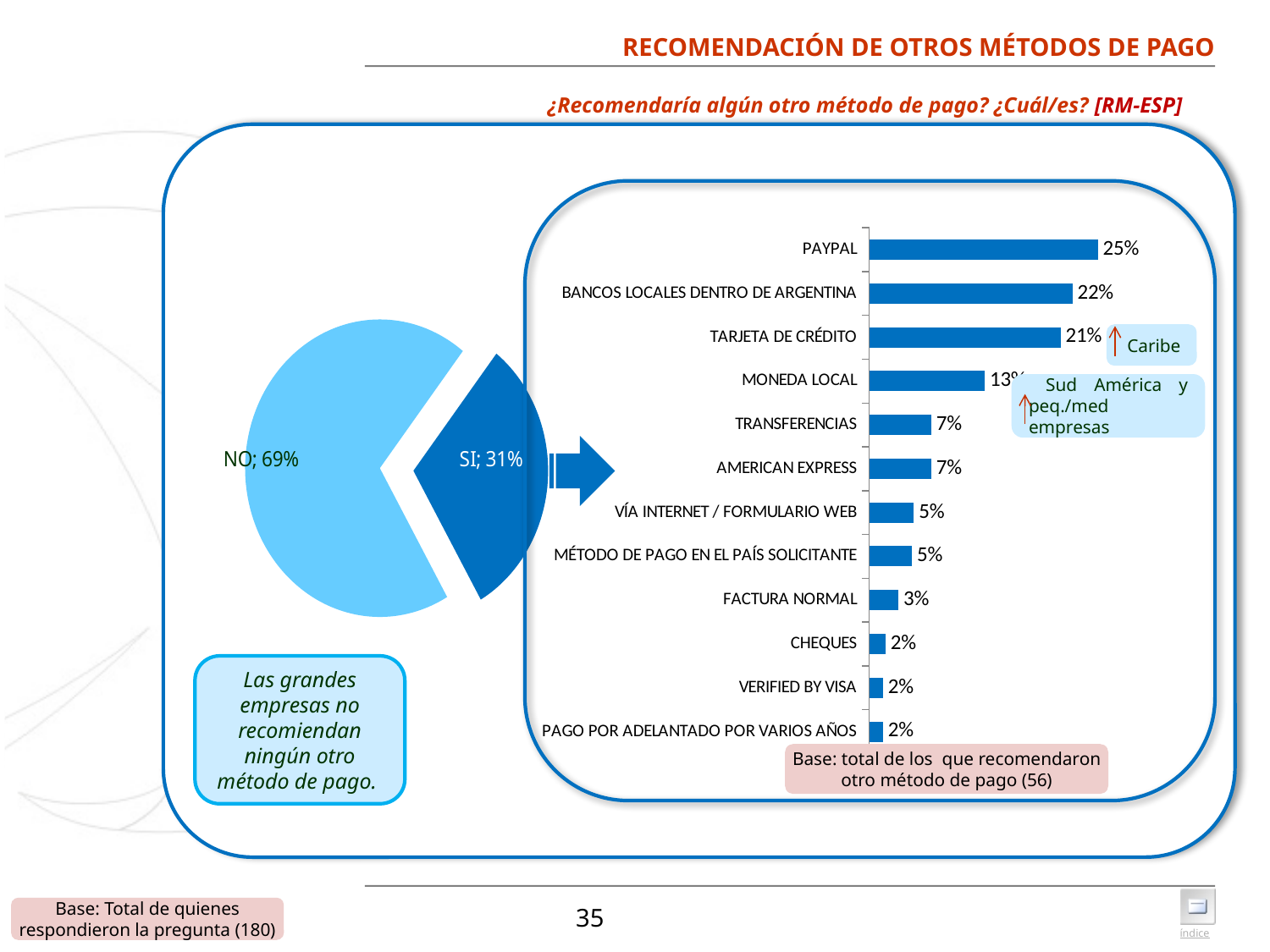
In the bar chart on the right, which is larger, TRANSFERENCIAS or VÍA INTERNET / FORMULARIO WEB? TRANSFERENCIAS In the bar chart on the right, what is the value for TARJETA DE CRÉDITO? 21% In the bar chart on the right, what is the value for BANCOS LOCALES DENTRO DE ARGENTINA? 22% In the bar chart on the right, which category has the highest value? PAYPAL How many categories are shown in the bar chart on the right? 12 In the bar chart on the right, what is the value for FACTURA NORMAL? 3% In the bar chart on the right, what is the value for PAYPAL? 25% In the bar chart on the right, what is the difference between PAYPAL and TARJETA DE CRÉDITO? 4% In the pie chart on the left, what share of respondents answered SI? 31% What type of chart is the chart on the right? Bar chart In the pie chart on the left, which slice is larger, NO or SI? NO In the pie chart on the left, what share of respondents answered NO? 69%